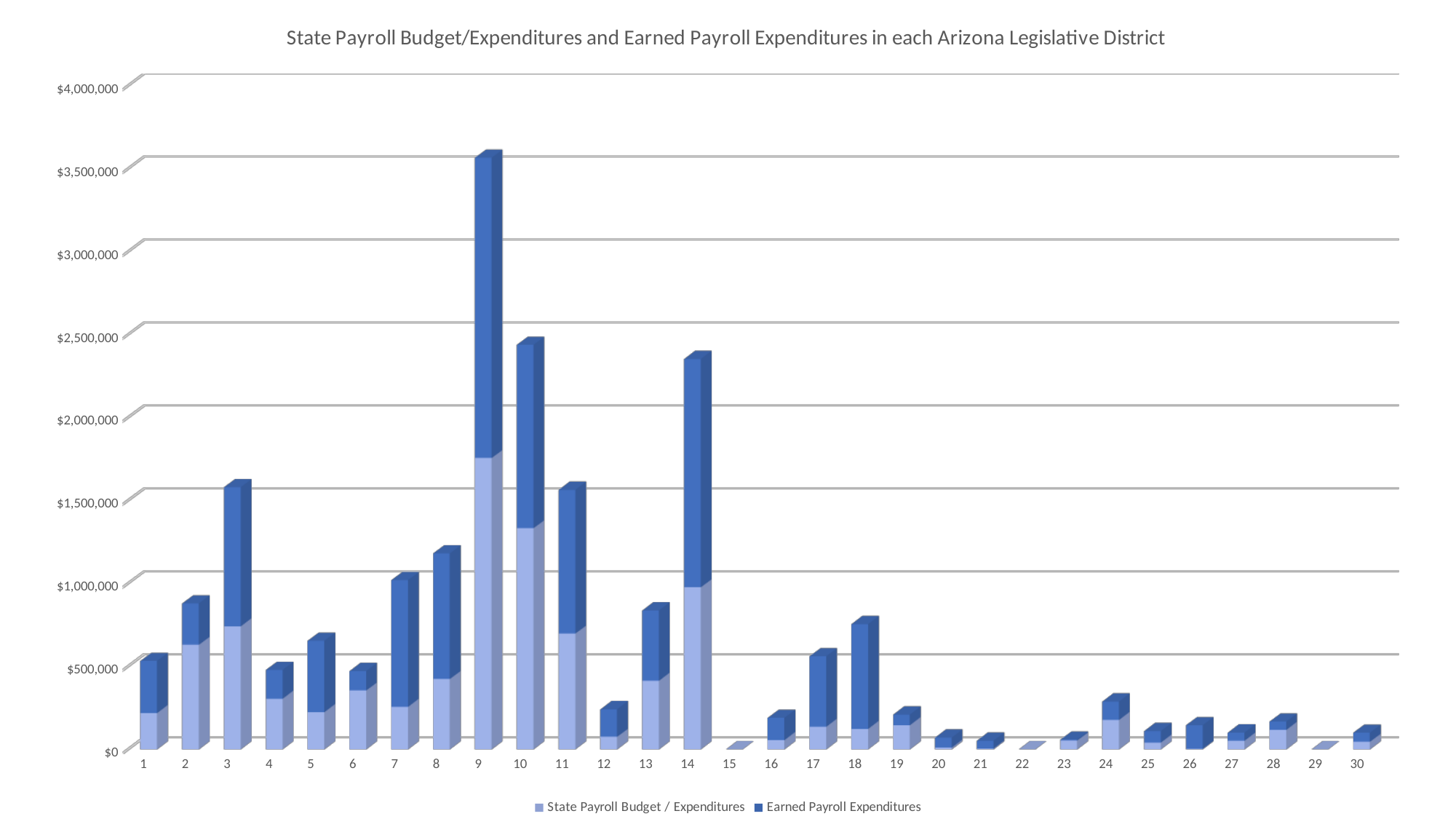
How many series does the legend list? 2 Is the total value for district 2 greater or less than $1,000,000? less Which has the larger total bar, district 9 or district 10? District 9 How many legislative districts are shown along the x axis? 30 What is the title of the chart? State Payroll Budget/Expenditures and Earned Payroll Expenditures in each Arizona Legislative District Which has the larger total bar, district 24 or district 19? District 24 Is the total value for district 8 greater or less than $1,000,000? greater Is the total value for district 9 greater or less than $3,000,000? greater Which district has the highest total bar? 9 What kind of chart is shown on the slide? Stacked bar chart